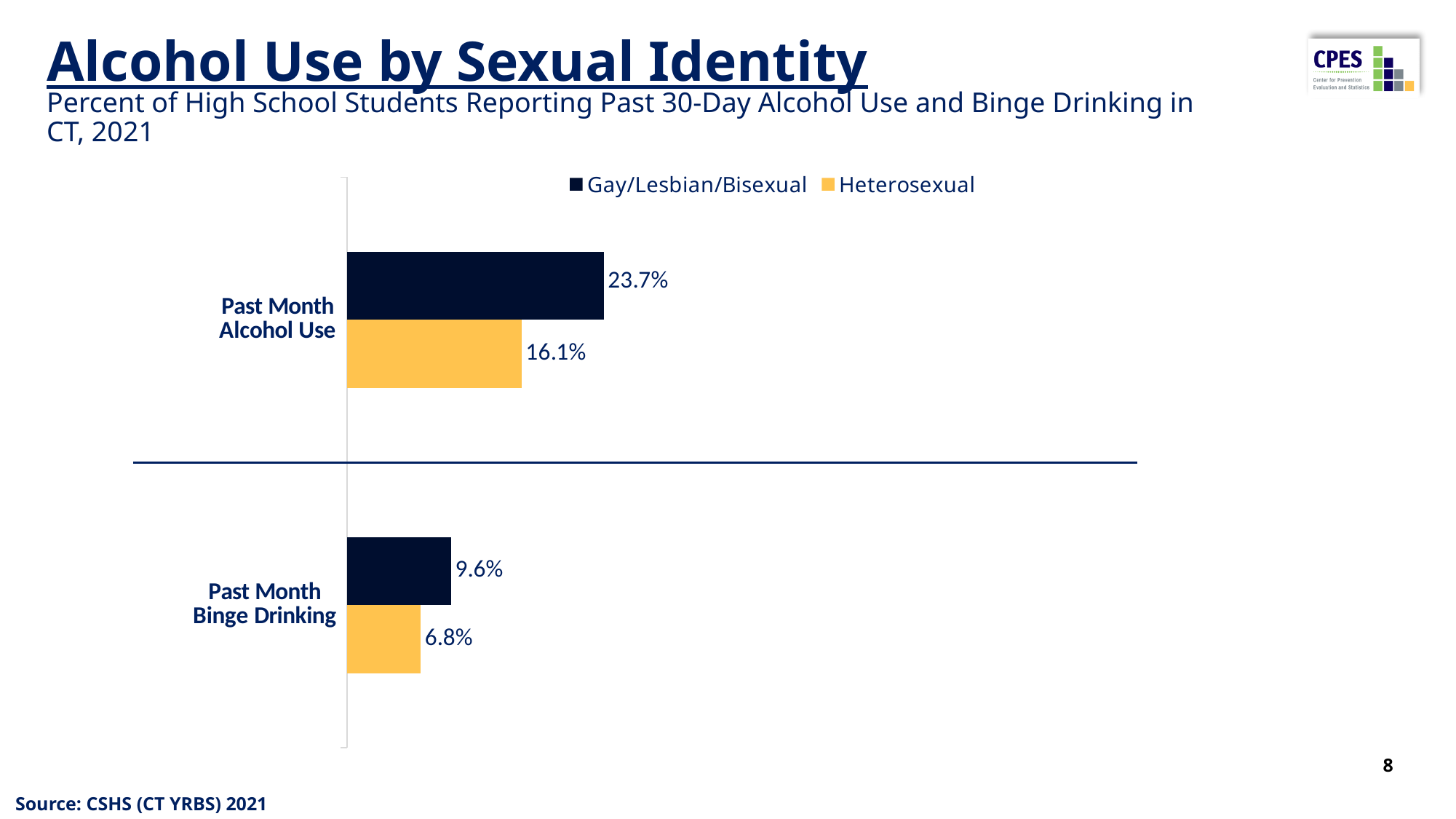
How many series does the legend list? 2 What is the difference in Past Month Binge Drinking between Gay/Lesbian/Bisexual and Heterosexual students? 2.8% How many categories are shown on the chart? 2 What percent of Gay/Lesbian/Bisexual students reported Past Month Alcohol Use? 23.7% What percent of Gay/Lesbian/Bisexual students reported Past Month Binge Drinking? 9.6% What kind of chart is shown on the slide? Bar chart What percent of Heterosexual students reported Past Month Alcohol Use? 16.1% What percent of Heterosexual students reported Past Month Binge Drinking? 6.8% For Past Month Binge Drinking, which group has the larger value, Gay/Lesbian/Bisexual or Heterosexual? Gay/Lesbian/Bisexual Which bar in the chart has the lowest value? Heterosexual, Past Month Binge Drinking Which bar in the chart has the highest value? Gay/Lesbian/Bisexual, Past Month Alcohol Use What is the difference in Past Month Alcohol Use between Gay/Lesbian/Bisexual and Heterosexual students? 7.6%